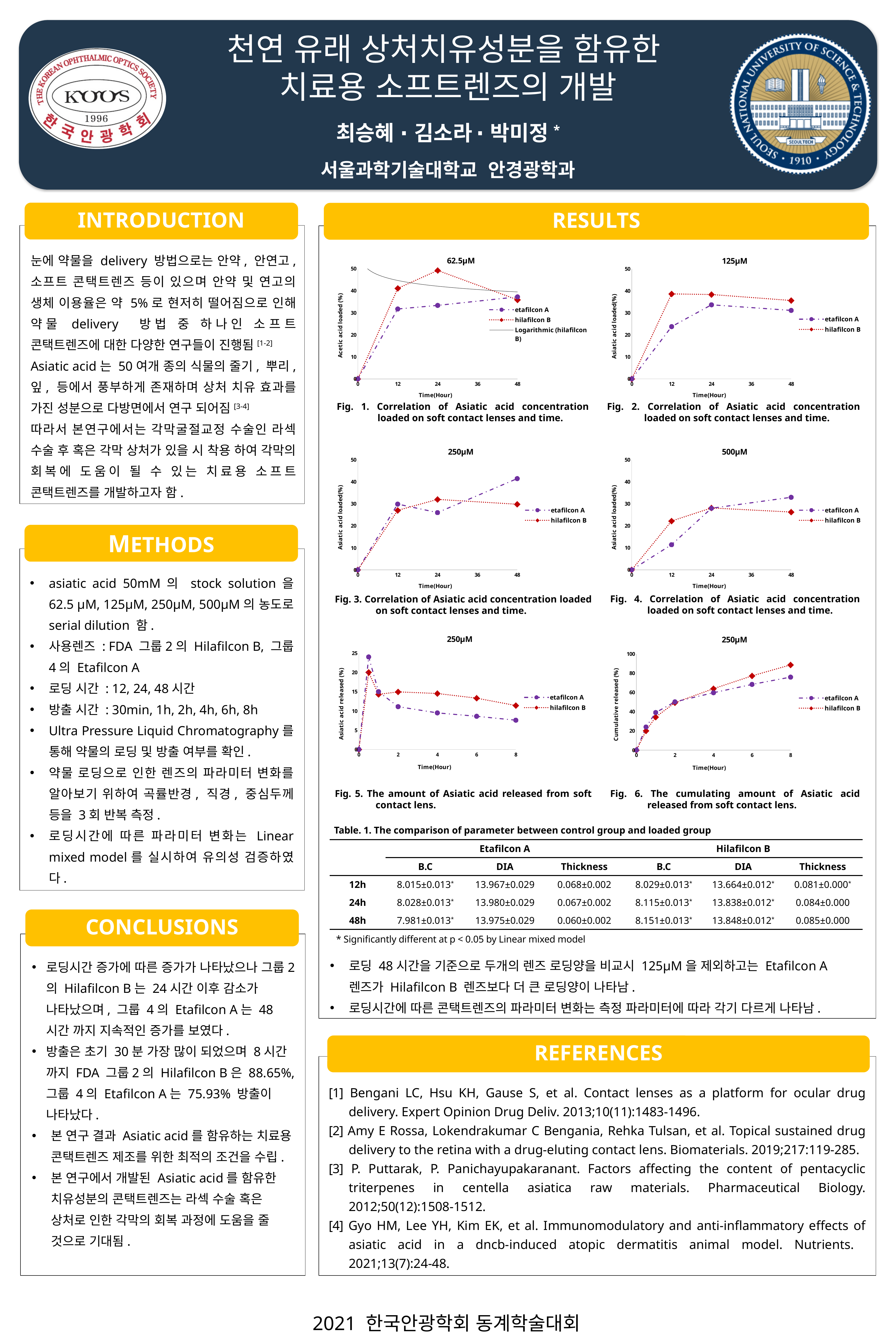
In Fig. 6 (cumulative released), which series is higher at 8 hours, etafilcon A or hilafilcon B? hilafilcon B In Fig. 5 (amount released), does the etafilcon A line rise or fall between 1 hour and 8 hours? fall In Fig. 2 (125μM), is the value for etafilcon A at 12 hours greater or less than 30? less In Fig. 6 (cumulative released), is the value for hilafilcon B at 8 hours greater or less than 80? greater What is the title shown above the chart in Fig. 1? 62.5μM How many entries does the legend of Fig. 1 (62.5μM) list? 3 In Fig. 4 (500μM), is the value for etafilcon A at 12 hours greater or less than 20? less What kind of chart is Fig. 1 (titled 62.5μM)? line chart How many series does the legend of Fig. 2 (125μM) list? 2 In Fig. 4 (500μM), which series has the higher value at 12 hours, etafilcon A or hilafilcon B? hilafilcon B In Fig. 3 (250μM, loaded), which series has the higher value at 48 hours, etafilcon A or hilafilcon B? etafilcon A